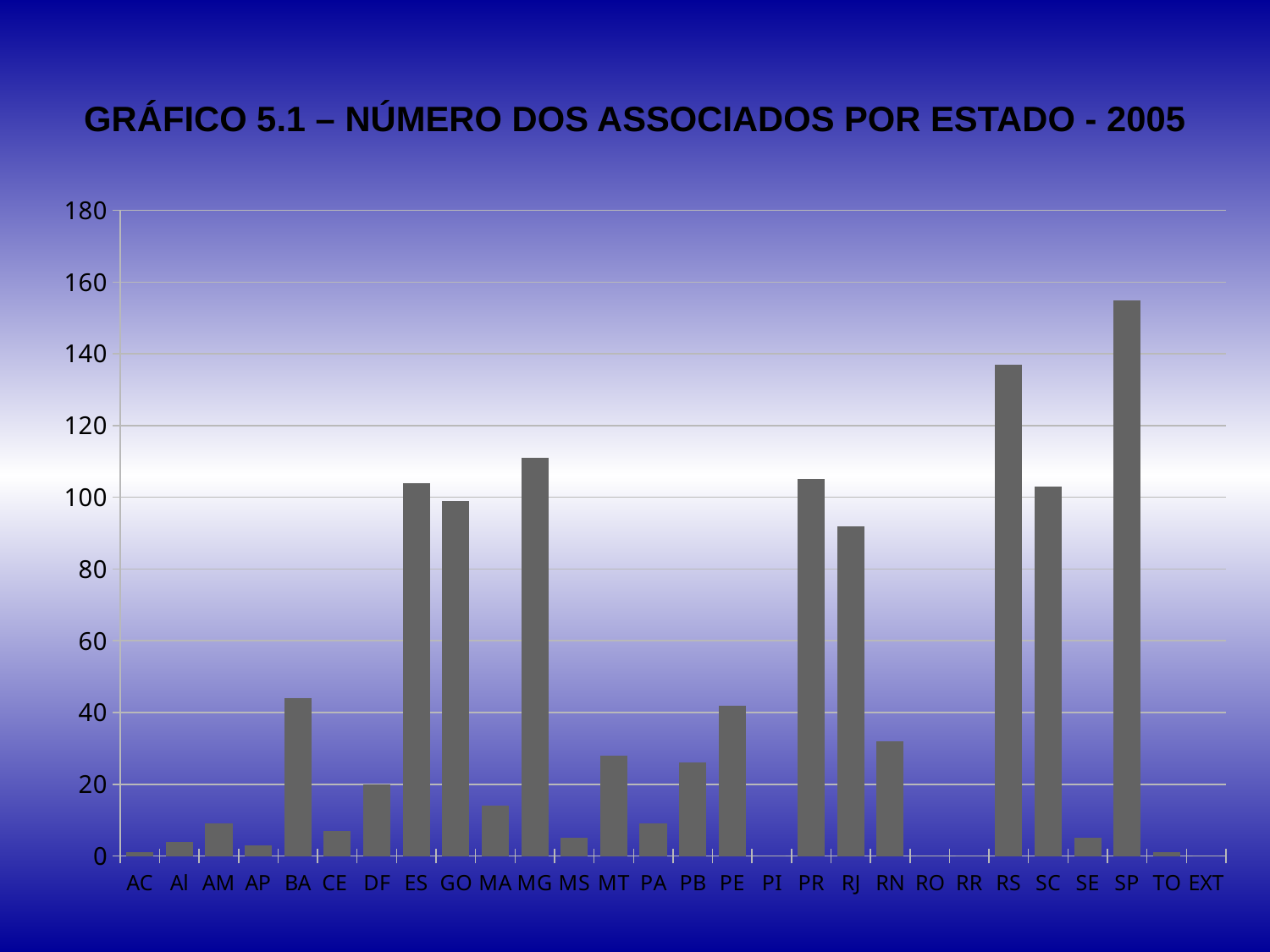
Is the value for RN greater or less than 20? greater Which has a larger value, RS or SC? RS Is the value for SP greater or less than 140? greater Is the value for RJ greater or less than 100? less What kind of chart is shown on the slide? bar chart Which has a larger value, SP or RS? SP Which state has the highest number of associates? SP How many categories are shown on the x axis of the chart? 28 What is the title of the chart? GRÁFICO 5.1 – NÚMERO DOS ASSOCIADOS POR ESTADO - 2005